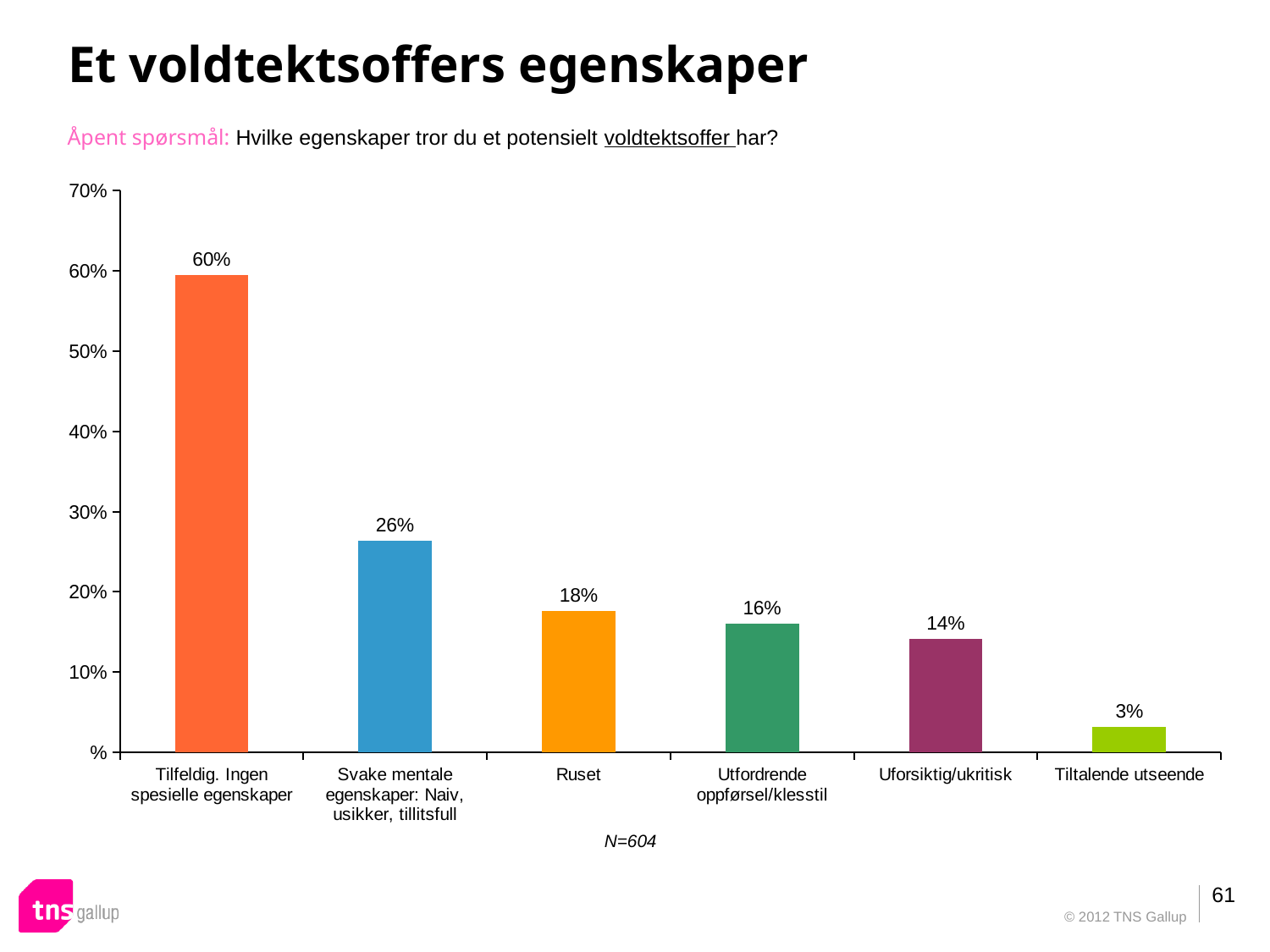
Do the values rise or fall from left to right along the x axis? fall What is the difference between the values for "Tilfeldig. Ingen spesielle egenskaper" and "Svake mentale egenskaper: Naiv, usikker, tillitsfull"? 34% Which is larger, the value for "Utfordrende oppførsel/klesstil" or the value for "Uforsiktig/ukritisk"? Utfordrende oppførsel/klesstil How many categories are shown on the x axis? 6 Is the value for "Ruset" greater or less than 20%? less Which category has the lowest value? Tiltalende utseende What is the value for "Tiltalende utseende"? 3% What is the value for "Ruset"? 18% Which category has the highest value? Tilfeldig. Ingen spesielle egenskaper What is the value for "Svake mentale egenskaper: Naiv, usikker, tillitsfull"? 26% What kind of chart is shown on the slide? bar chart What is the value for "Uforsiktig/ukritisk"? 14%